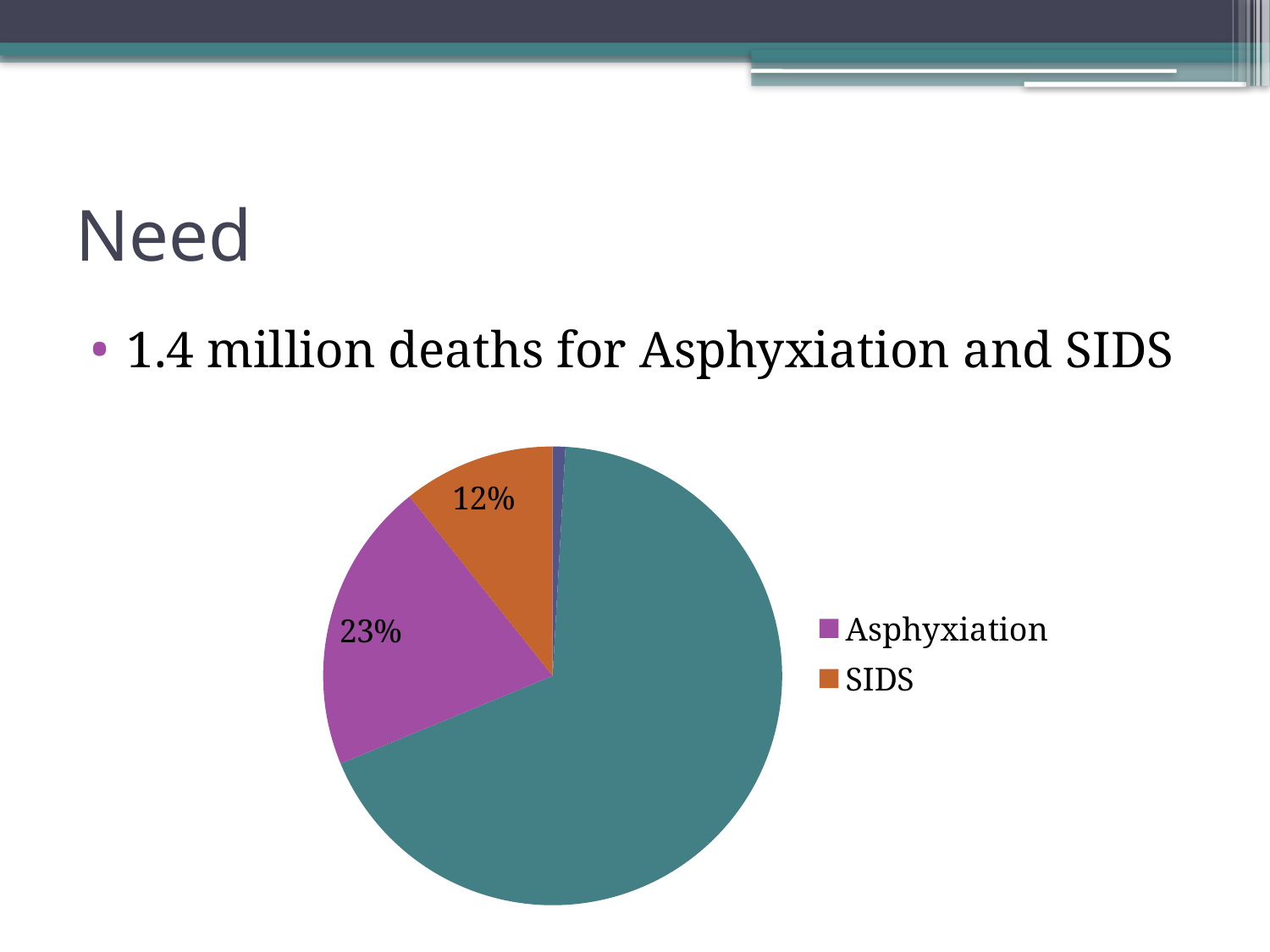
What is the value shown for the SIDS slice? 12% Of the two categories listed in the legend, which has the smaller share? SIDS What is the value shown for the Asphyxiation slice? 23% What kind of chart is shown on the slide? Pie chart By how many percentage points does the Asphyxiation share exceed the SIDS share? 11 percentage points What share of the pie does SIDS account for? 12% How many entries does the chart legend list? 2 What colour is the SIDS slice? Orange What colour is the Asphyxiation slice? Purple What share of the pie does Asphyxiation account for? 23% Which has the larger share, Asphyxiation or SIDS? Asphyxiation